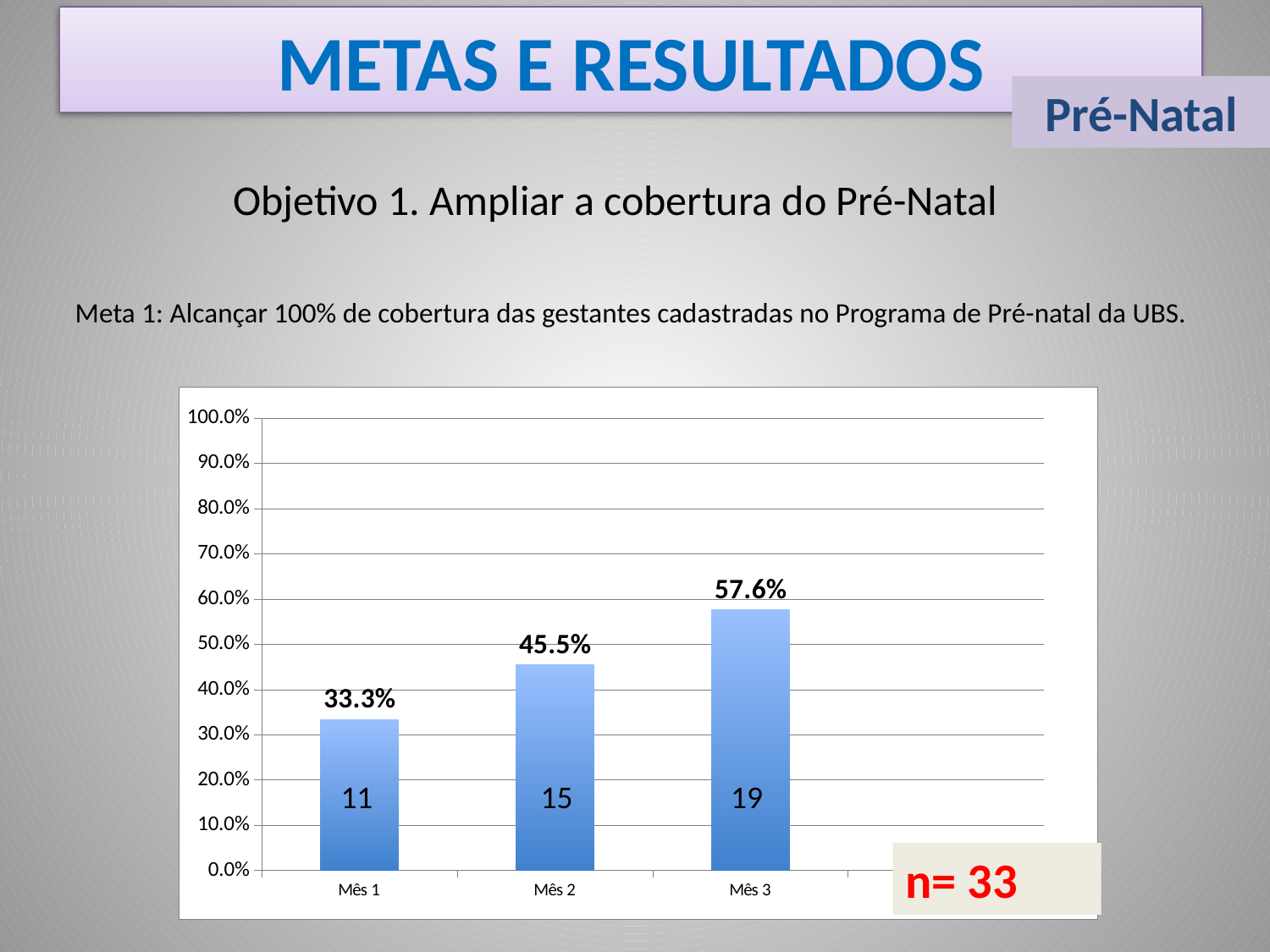
Which is larger, the value for Mês 2 or the value for Mês 1? Mês 2 What is the difference in percentage points between Mês 3 and Mês 1? 24.3 What is the percentage value shown for Mês 2? 45.5% How many months (categories) are shown on the x axis? 3 Which month has the lowest percentage? Mês 1 What is the percentage value shown for Mês 1? 33.3% Which month has the highest percentage? Mês 3 What is the percentage value shown for Mês 3? 57.6% What count is printed inside the bar for Mês 3? 19 What kind of chart is shown on the slide? Bar chart Do the values rise or fall from Mês 1 to Mês 3? Rise What count is printed inside the bar for Mês 1? 11